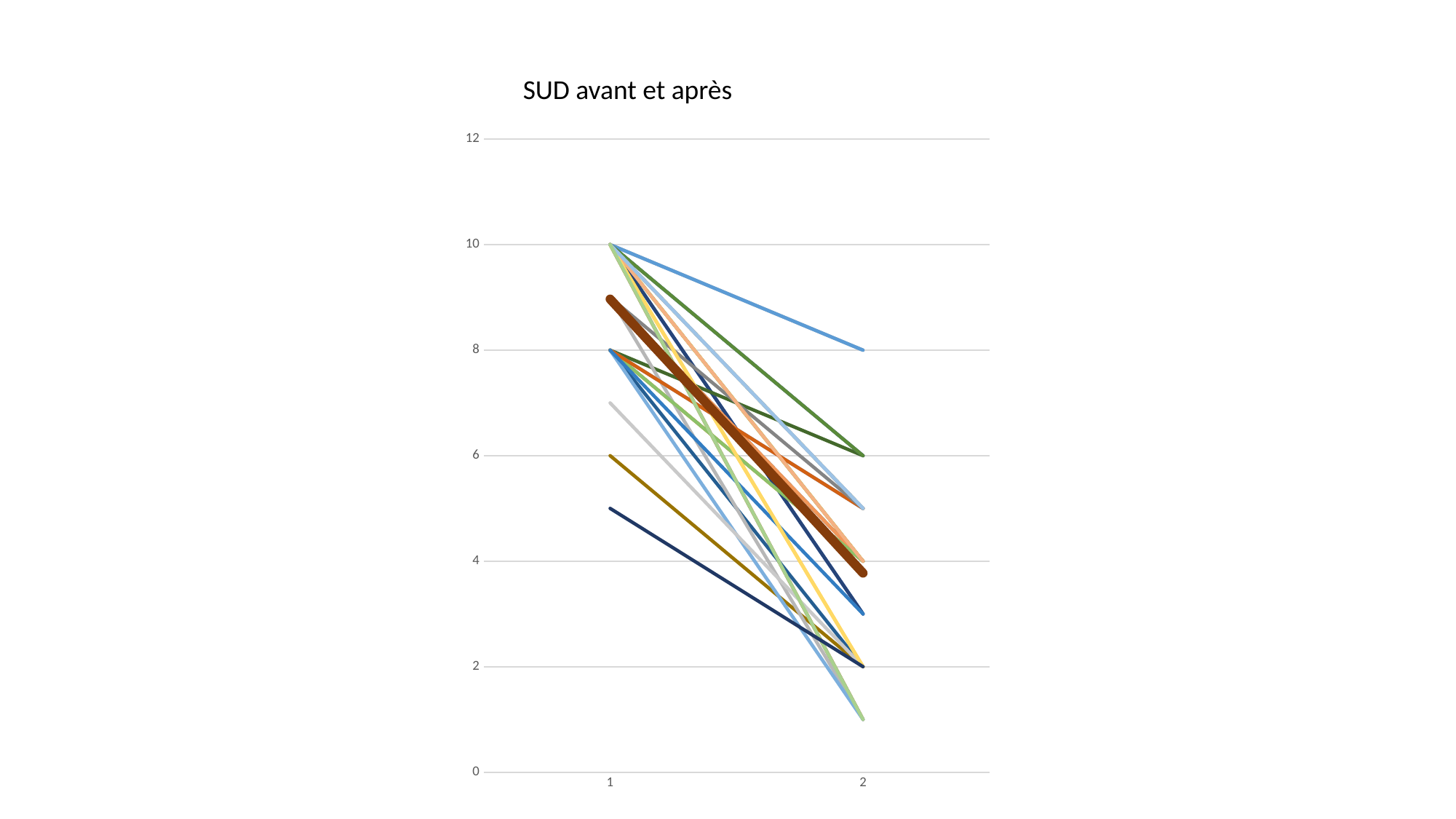
Is the value of the thick brown line larger at point 1 or at point 2? point 1 Is the value of the thick brown line at point 1 greater or less than 8? greater What is the highest value reached by any line at point 2? 8 How many points are there on the x axis? 2 Do the lines rise or fall from point 1 to point 2? fall What is the highest tick value shown on the y axis? 12 Is the lowest value reached by any line at point 2 greater or less than 2? less What kind of chart is shown on the slide? line chart What is the title of the chart? SUD avant et après Is the value of the thick brown line at point 2 greater or less than 6? less What is the highest value reached by any line at point 1? 10